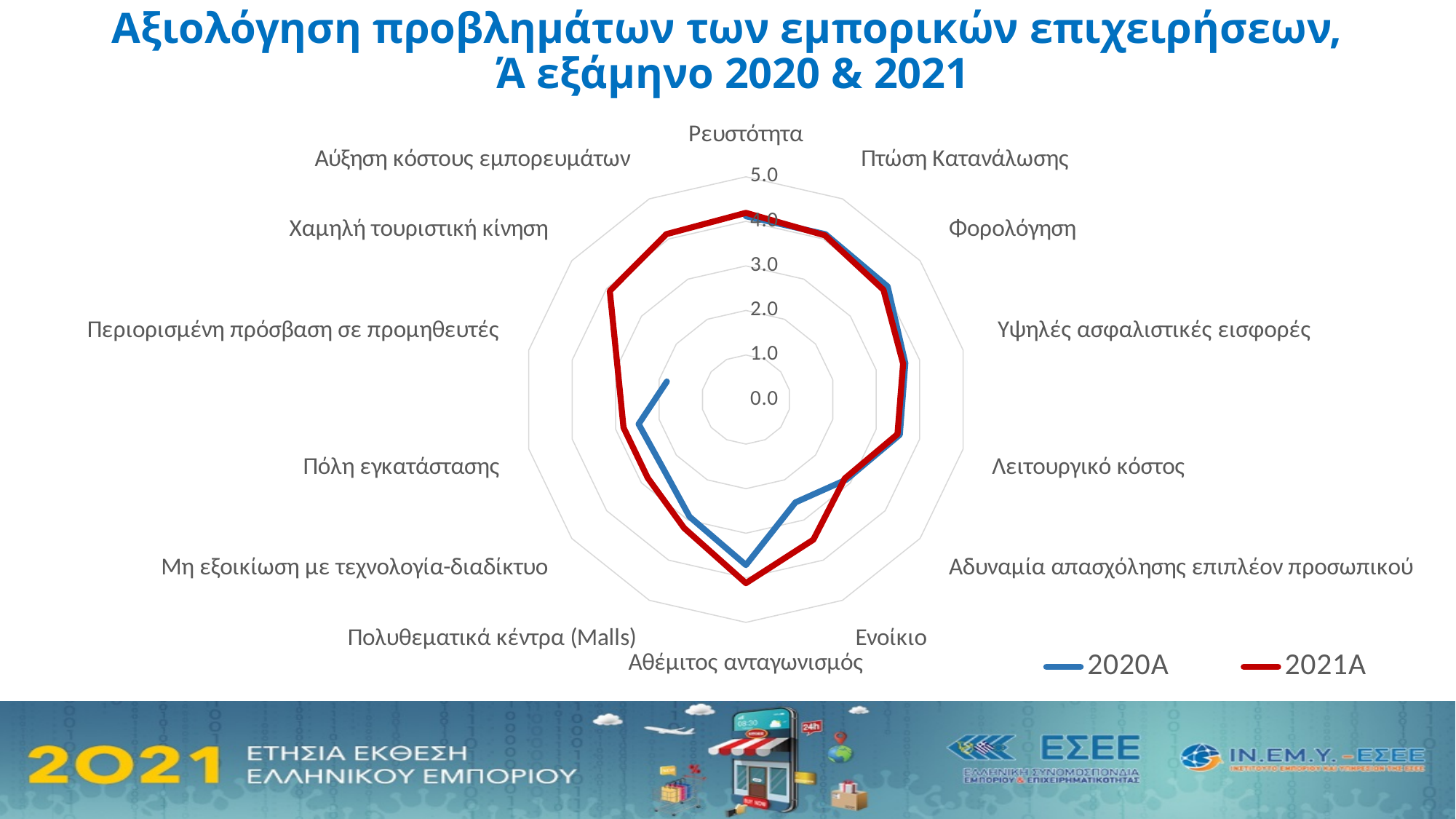
How many series does the legend list? 2 How many categories (axes) does the radar chart have? 14 What is the highest value shown on the radial axis? 5.0 Is the 2021A value for Ρευστότητα greater or less than 3.0? greater Is the 2020A value for Περιορισμένη πρόσβαση σε προμηθευτές greater or less than 3.0? less Which two series are listed in the legend? 2020A and 2021A What kind of chart is shown on the slide? Radar chart For Αθέμιτος ανταγωνισμός, which series has the larger value, 2020A or 2021A? 2021A What colour is the line for the 2021A series? Red For Ενοίκιο, which series has the larger value, 2020A or 2021A? 2021A Is the 2020A value for Ενοίκιο greater or less than 3.0? less